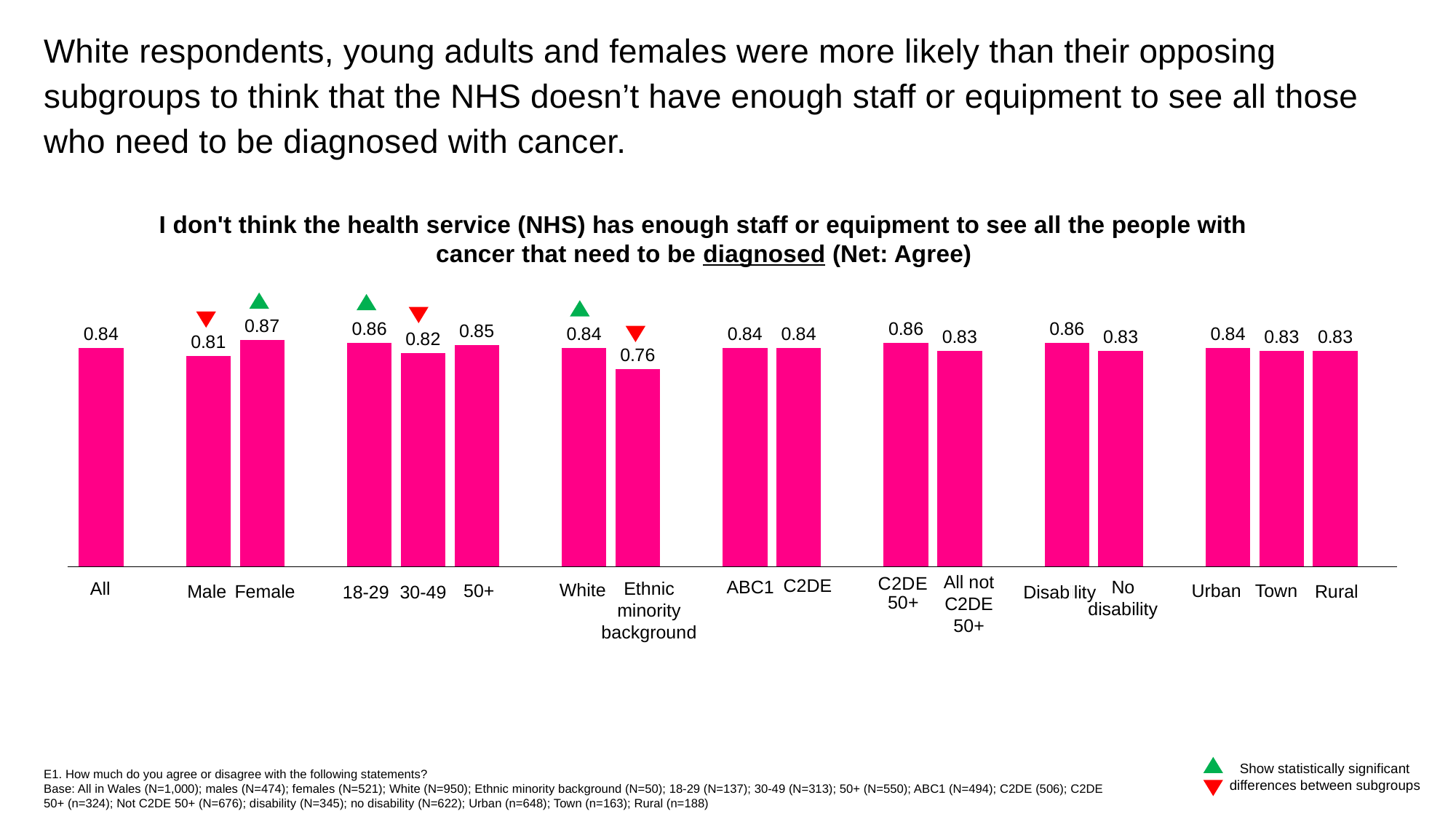
What is the value for the All category? 0.84 Which category has the lowest value? Ethnic minority background What is the difference between the values for Female and Male? 0.06 What is the difference between the values for White and Ethnic minority background? 0.08 What colour are the bars in the chart? Pink How many bars are plotted in the chart? 17 What is the value for Ethnic minority background? 0.76 What type of chart is shown? Bar chart What is the value for Female? 0.87 Which is larger, the value for 18-29 or the value for 30-49? 18-29 What is the value for 30-49? 0.82 Which category has the highest value? Female